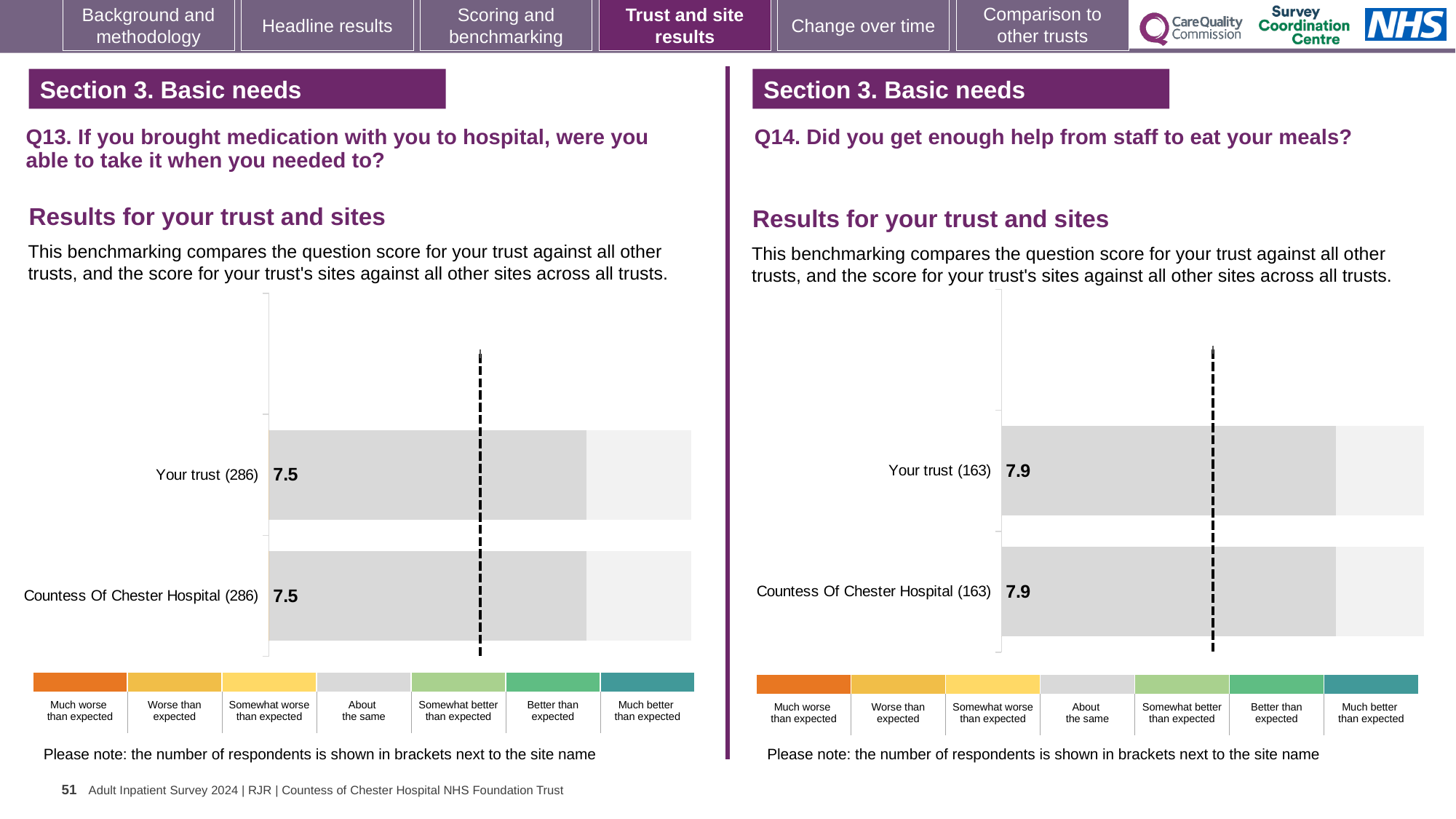
In the Q14 chart on the right, what is the difference between the score for Your trust and the score for Countess Of Chester Hospital? 0 In the Q14 chart on the right, what is the score for Countess Of Chester Hospital (163)? 7.9 Is the Your trust score in the Q13 chart on the left larger or smaller than the Your trust score in the Q14 chart on the right? smaller How many categories does the colour key below the Q13 chart on the left list? 7 In the Q14 chart on the right, what is the score for Your trust (163)? 7.9 In the Q13 chart on the left, what is the difference between the score for Your trust and the score for Countess Of Chester Hospital? 0 In the Q13 chart on the left, what is the score for Countess Of Chester Hospital (286)? 7.5 In the Q13 chart on the left, what is the score for Your trust (286)? 7.5 How many bars are plotted in the Q14 chart on the right? 2 How many bars are plotted in the Q13 chart on the left? 2 What kind of chart is used for the Q13 results on the left? bar chart How many respondents are shown in brackets for Your trust in the Q14 chart on the right? 163